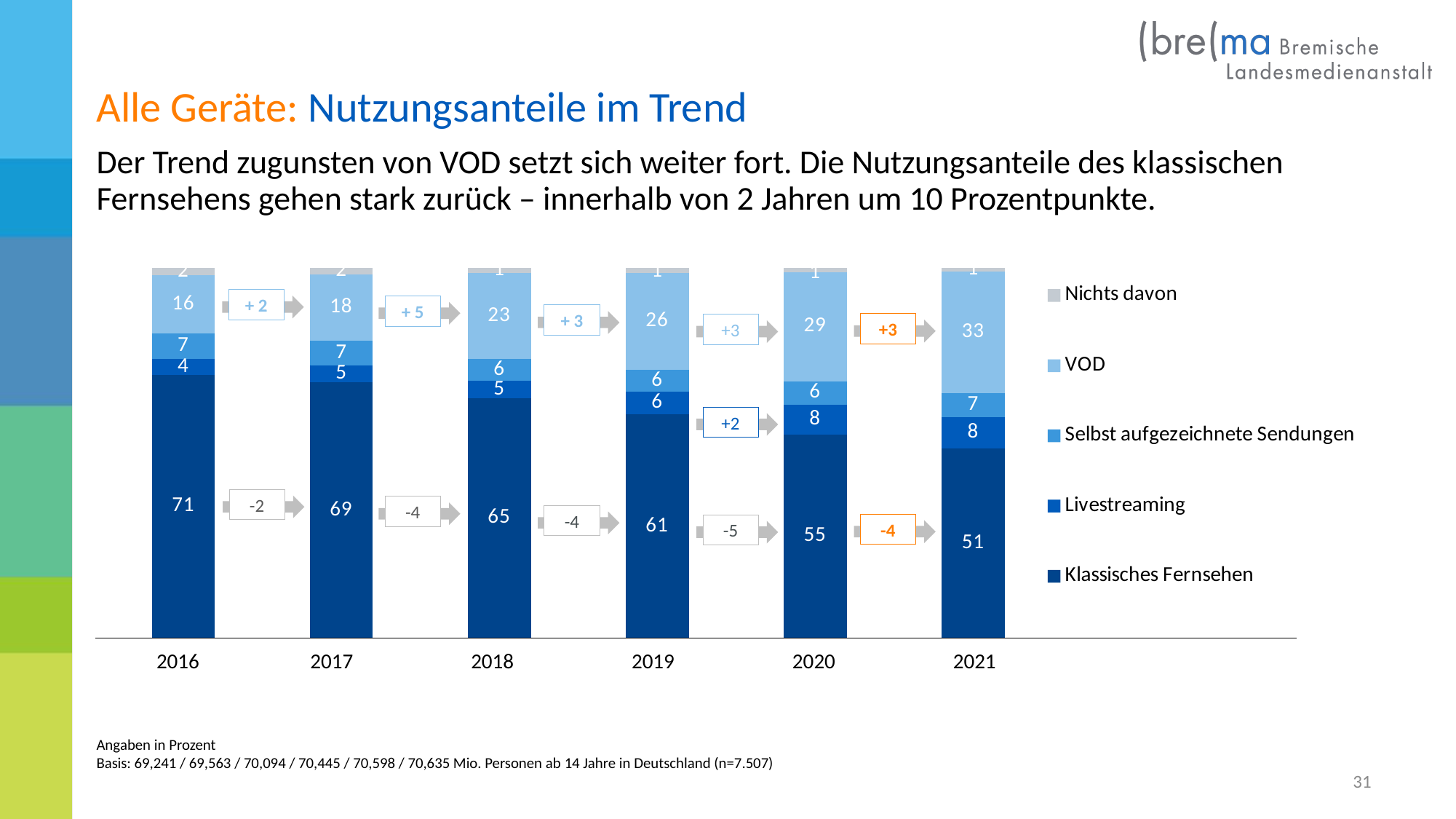
What kind of chart is shown on the slide? Stacked bar chart How many series does the legend list? 5 What is the value for VOD in 2018? 23 In which year is the value for VOD lowest? 2016 What is the difference between the Klassisches Fernsehen values for 2016 and 2021? 20 What is the value for Klassisches Fernsehen in 2021? 51 What is the value for Selbst aufgezeichnete Sendungen in 2016? 7 Which is larger in 2019: the value for VOD or the value for Livestreaming? VOD How many years are shown on the x axis? 6 In which year is the value for Klassisches Fernsehen highest? 2016 Do the values for VOD rise or fall from 2016 to 2021? Rise What is the value for Livestreaming in 2020? 8